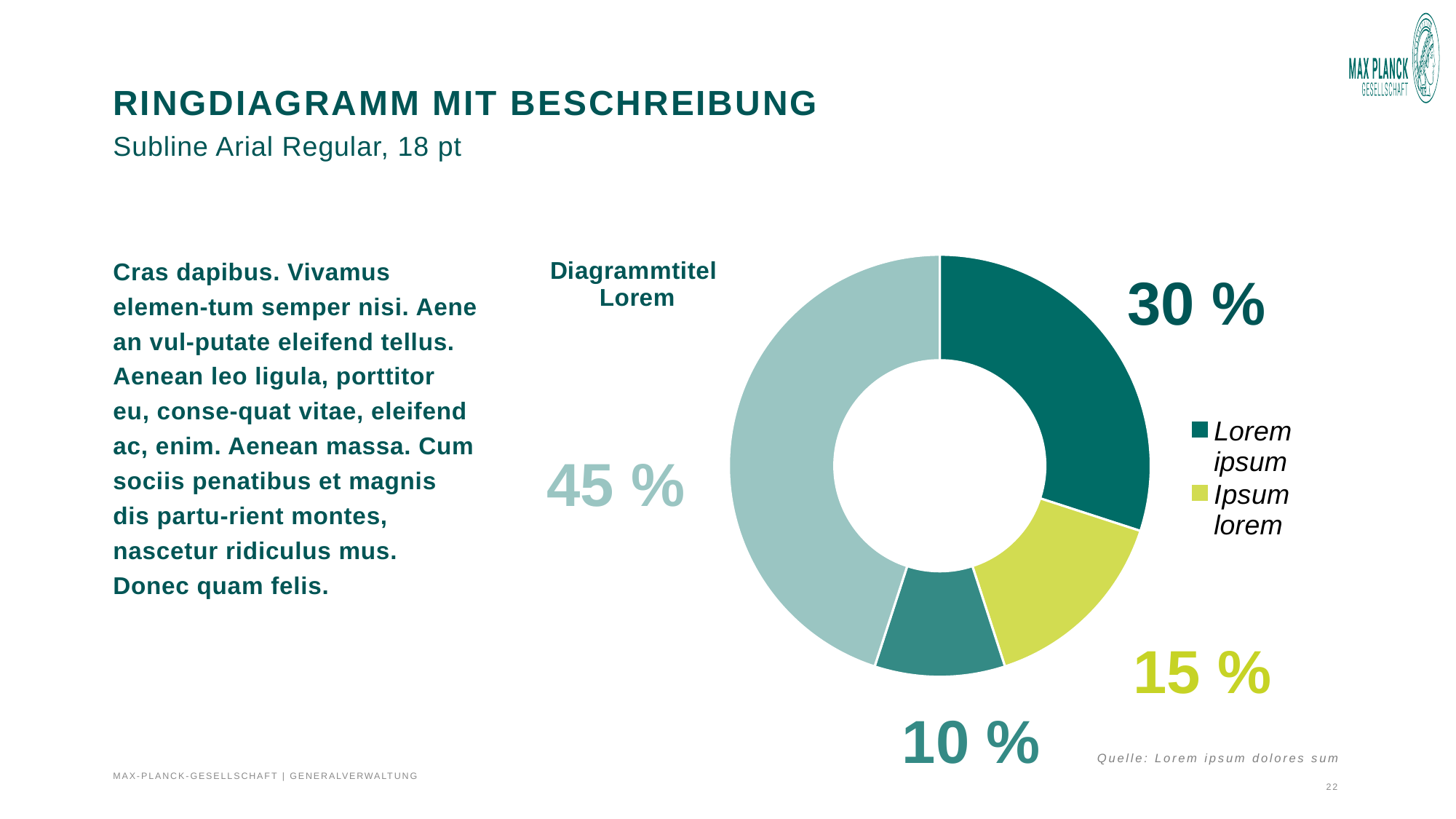
What is the smallest percentage shown on the doughnut chart? 10 % What is the title of the chart? Diagrammtitel Lorem Which legend entry has the larger share, Lorem ipsum or Ipsum lorem? Lorem ipsum How many slices does the doughnut chart have? 4 What kind of chart is shown on the slide? Doughnut (ring) chart What is the sum of all four percentages shown on the doughnut chart? 100 % What percentage is shown for the Ipsum lorem slice of the doughnut chart? 15 % What is the largest percentage shown on the doughnut chart? 45 % What percentage is shown for the Lorem ipsum slice of the doughnut chart? 30 % By how many percentage points does the Lorem ipsum slice exceed the Ipsum lorem slice? 15 % How many entries does the chart legend list? 2 Which legend entry is shown in dark teal? Lorem ipsum